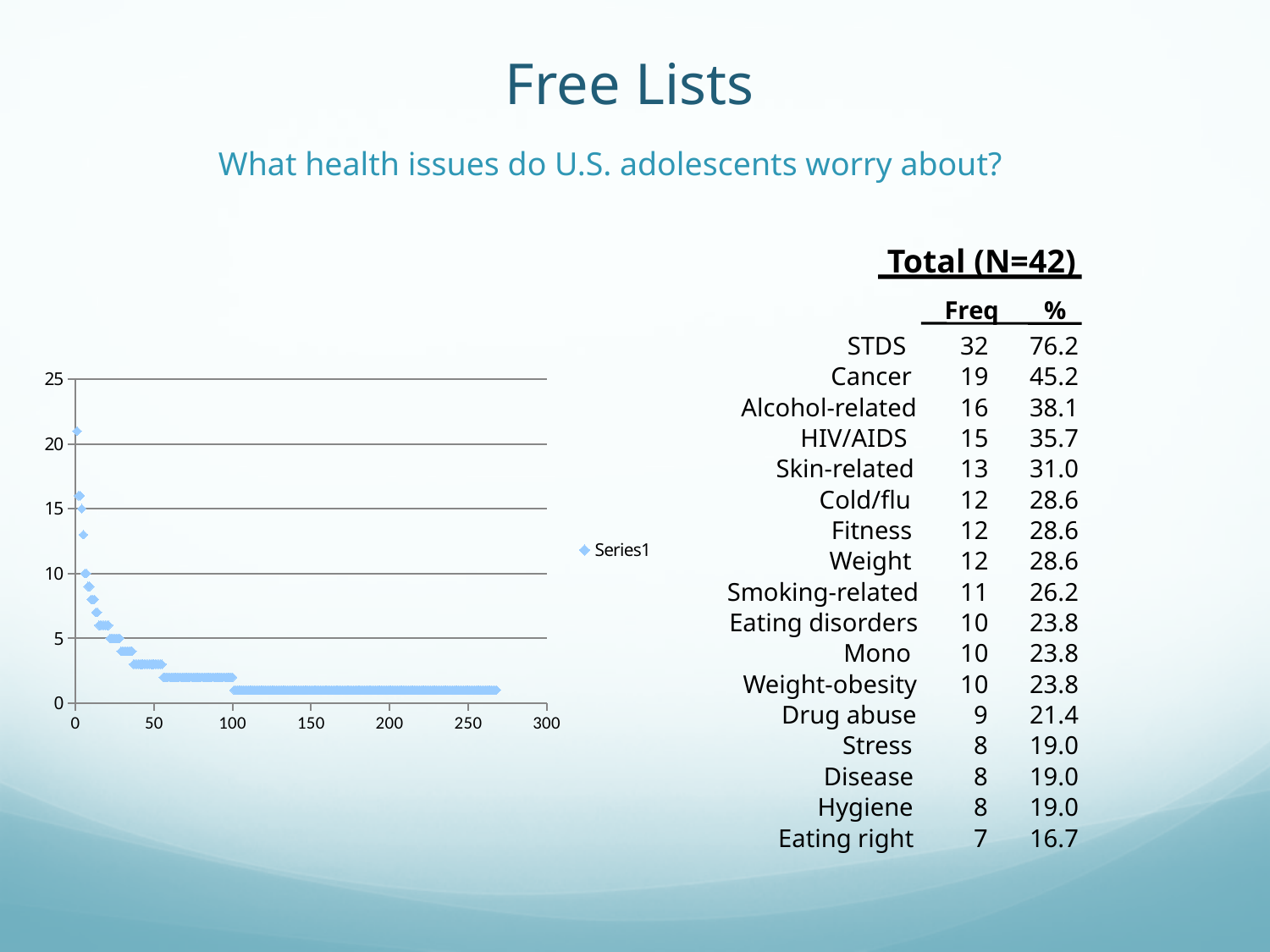
Is the value of the first plotted point (at the far left of the x axis) greater or less than 15? greater Is the plotted value at x = 200 greater or less than 5? less Where along the x axis does the highest plotted value occur? at the far left, near x = 0 Is the highest plotted value greater or less than 25? less What is the name of the series shown in the chart's legend? Series1 How many series does the chart's legend list? 1 What kind of chart is shown on the slide? scatter chart What is the highest tick value shown on the chart's y axis? 25 Do the plotted values rise or fall as the x axis increases? fall